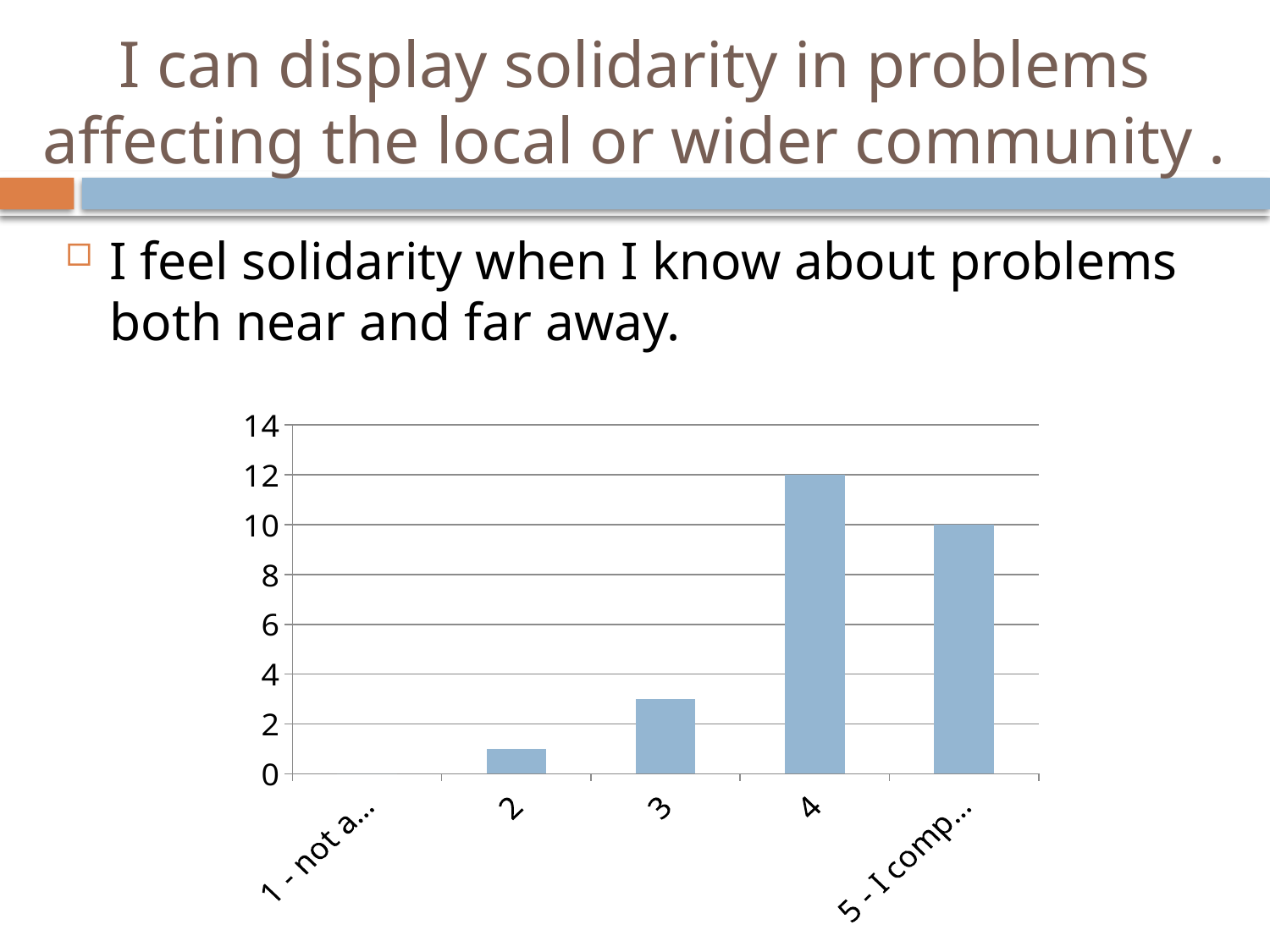
Is the value for category 3 greater or less than 2? greater What is the value for category 4? 12 What is the highest value shown on the vertical axis of the chart? 14 What is the difference between the value for category 4 and the value for the rightmost category "5 - I comp..."? 2 What kind of chart is shown on the slide? bar chart What is the value for the rightmost category, "5 - I comp..."? 10 Which category has the highest value? 4 Is the value for category 2 greater or less than 2? less Which is larger, the value for category 4 or the value for the rightmost category "5 - I comp..."? 4 Which category has the shortest visible bar? 2 How many categories are shown on the x axis of the chart? 5 Is the value for category 3 greater or less than 4? less